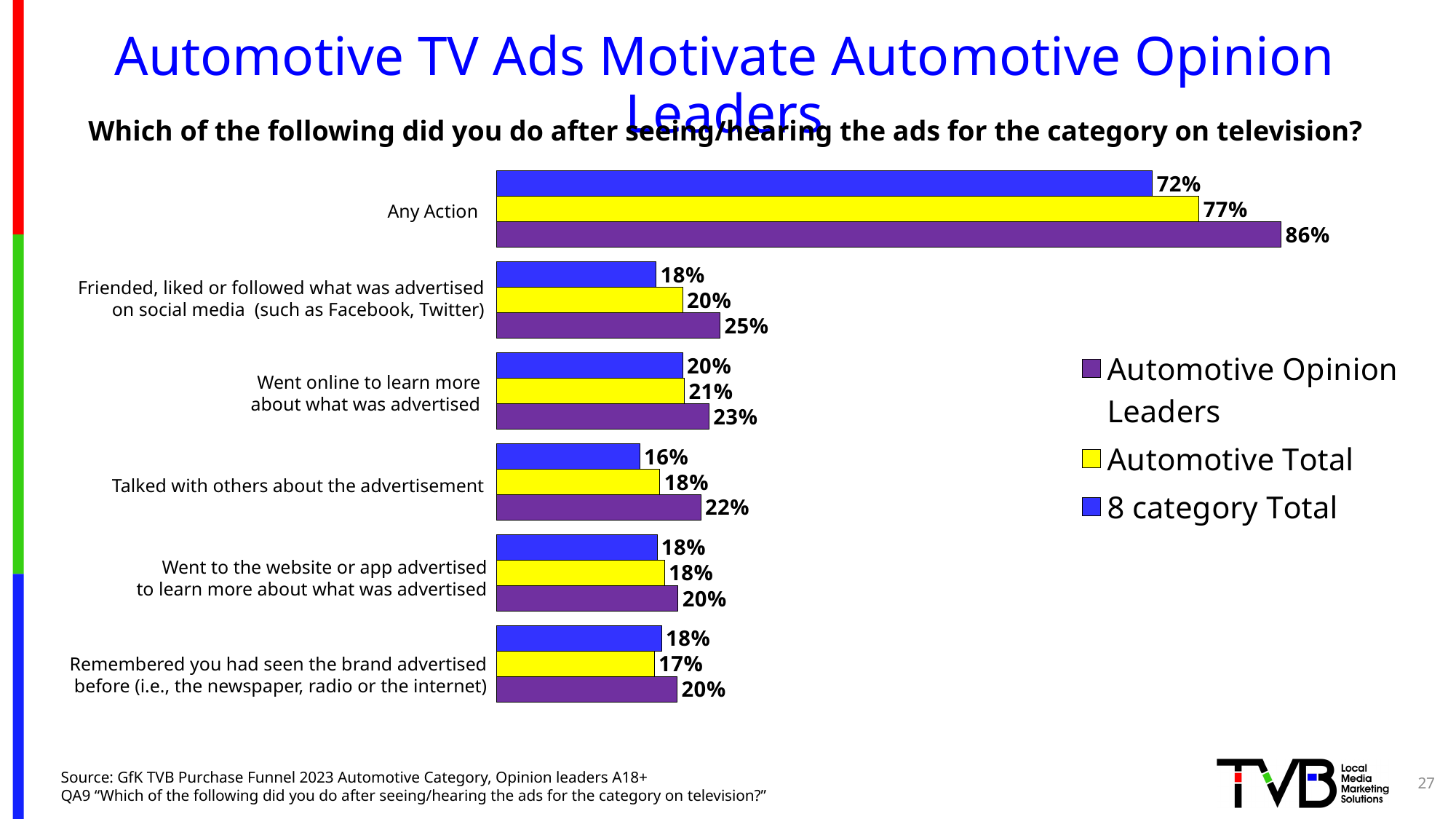
How many categories are shown on the chart? 6 What is the value for Automotive Opinion Leaders for Friended, liked or followed what was advertised on social media? 25% Which category has the lowest value for 8 category Total? Talked with others about the advertisement What kind of chart is shown on the slide? Bar chart What is the value for Automotive Total for Remembered you had seen the brand advertised before? 17% What is the value for 8 category Total for Talked with others about the advertisement? 16% Which category has the highest value for Automotive Opinion Leaders? Any Action What is the value for Automotive Opinion Leaders for Any Action? 86% What is the difference between Automotive Opinion Leaders and 8 category Total for Any Action? 14% How many series does the legend list? 3 For Went online to learn more about what was advertised, which is larger: Automotive Opinion Leaders or Automotive Total? Automotive Opinion Leaders What is the value for Automotive Total for Any Action? 77%